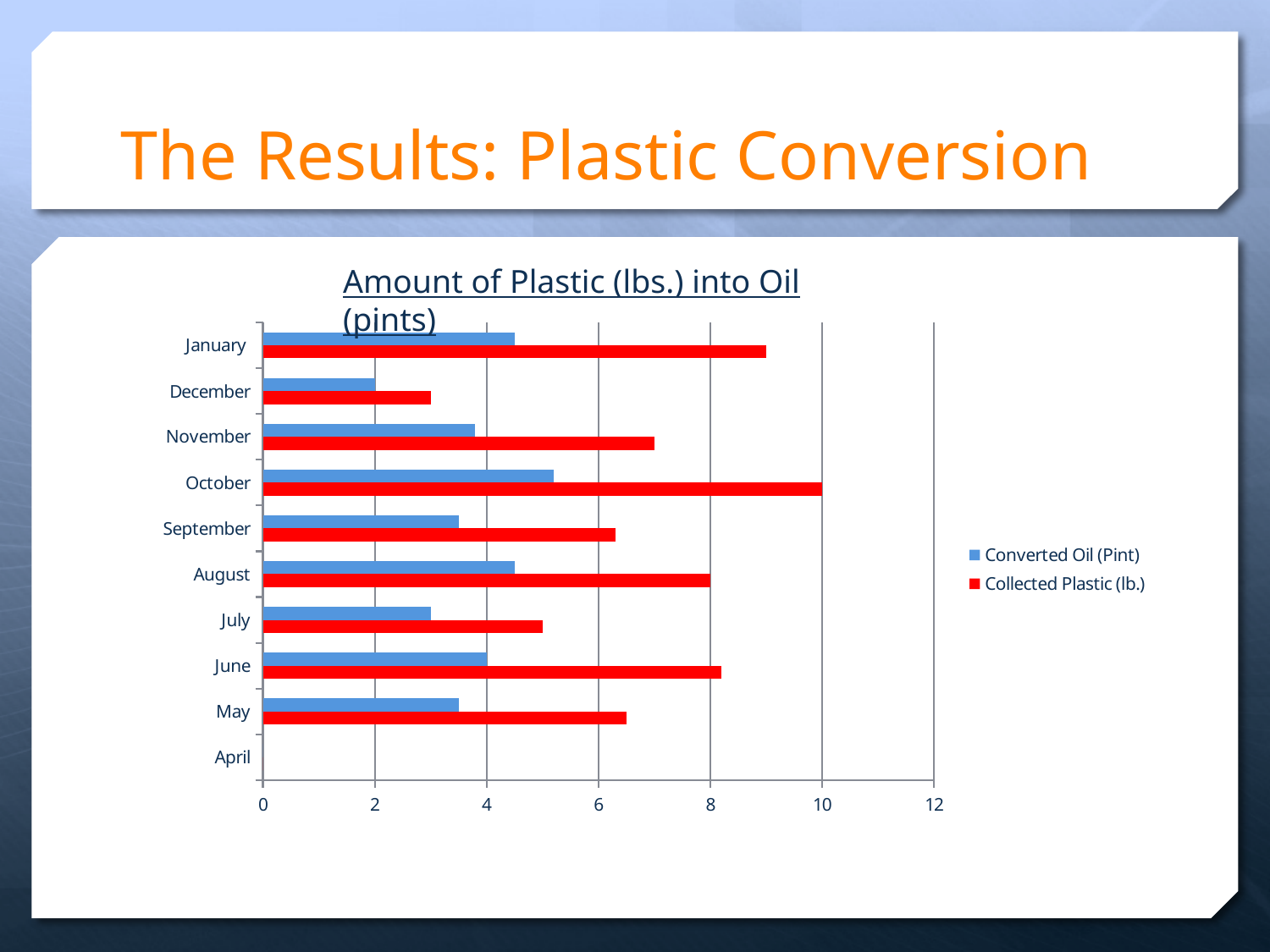
Which month has the highest Collected Plastic (lb.) value? October Which month has the larger Collected Plastic (lb.) value, June or July? June Is the Converted Oil (Pint) value for September greater or less than 4? less What is the Converted Oil (Pint) value for December? 2 Is the Collected Plastic (lb.) value for January greater or less than 8? greater What is the Collected Plastic (lb.) value for August? 8 What type of chart is shown on the slide? Bar chart What is the title of the chart? Amount of Plastic (lbs.) into Oil (pints) What is the Collected Plastic (lb.) value for October? 10 How many months are listed on the vertical axis of the chart? 10 How many series does the legend list? 2 What is the difference between the Collected Plastic (lb.) values for October and August? 2